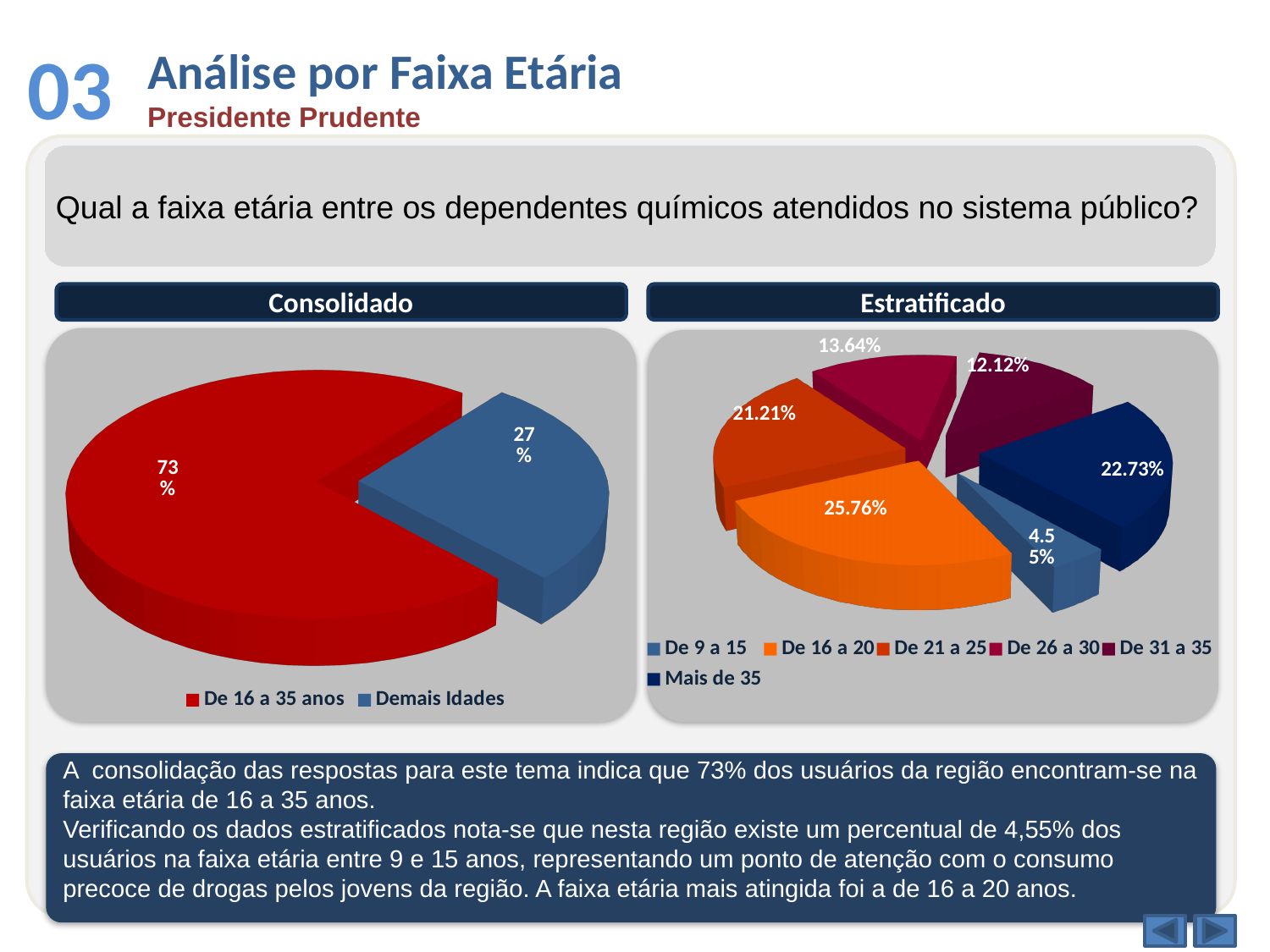
In the Consolidado chart, what is the difference between De 16 a 35 anos and Demais Idades? 46% In the Estratificado chart, which is larger: De 21 a 25 or De 26 a 30? De 21 a 25 In the Consolidado chart, what is the value for Demais Idades? 27% In the Estratificado chart, which age group has the largest share? De 16 a 20 How many categories does the Estratificado chart's legend list? 6 In the Consolidado chart, what is the value for De 16 a 35 anos? 73% What kind of chart is the Consolidado chart? Pie chart In the Estratificado chart, what is the difference between De 16 a 20 and De 31 a 35? 13.64% In the Estratificado chart, which age group has the smallest share? De 9 a 15 In the Estratificado chart, what is the value for Mais de 35? 22.73% In the Estratificado chart, what is the value for De 16 a 20? 25.76% In the Estratificado chart, what is the value for De 9 a 15? 4.55%